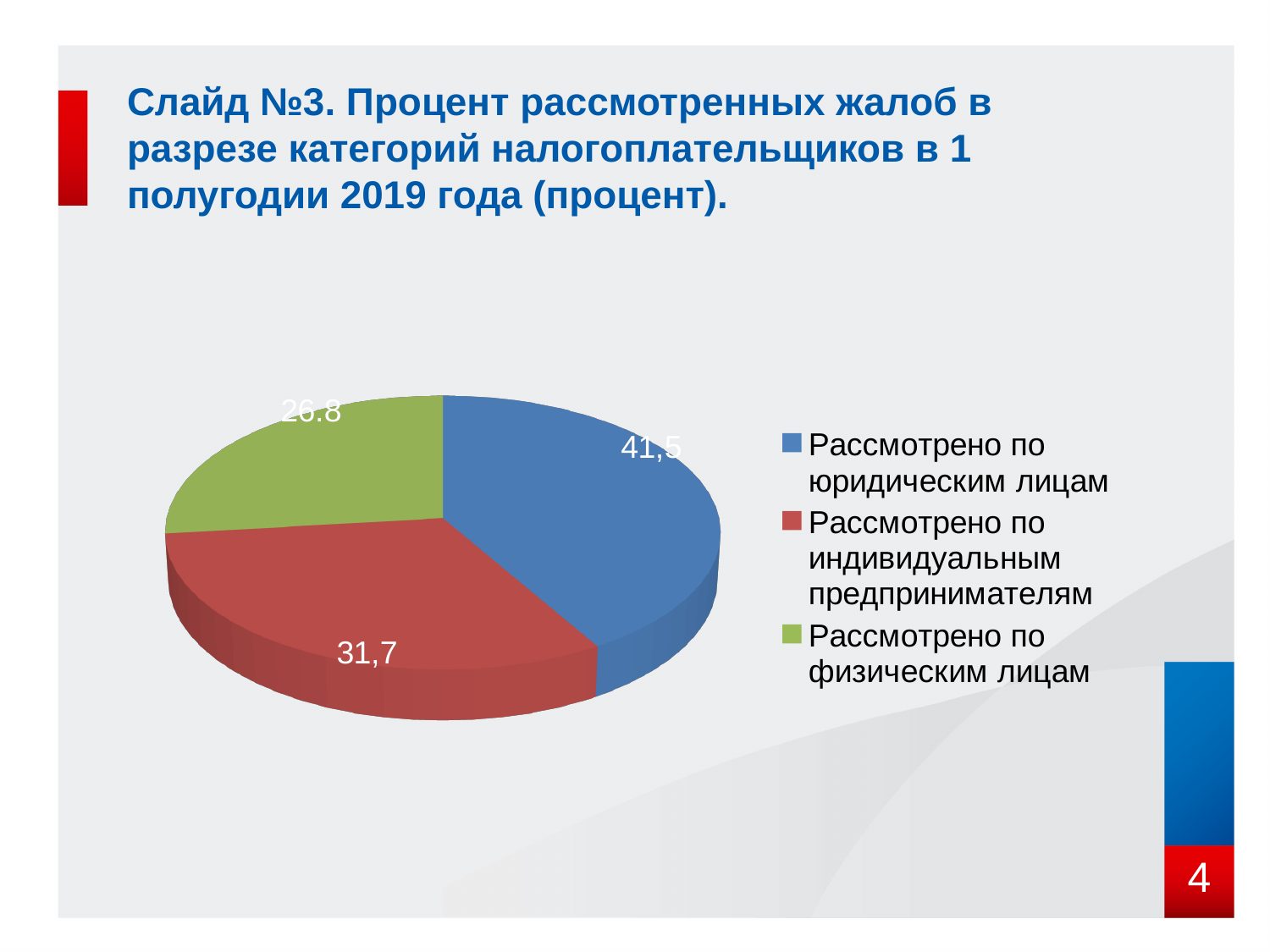
What colour is the slice for "Рассмотрено по физическим лицам"? Green What is the difference between the values for "Рассмотрено по индивидуальным предпринимателям" and "Рассмотрено по физическим лицам"? 4,9 How many slices does the pie chart have? 3 What value is shown for the slice "Рассмотрено по индивидуальным предпринимателям"? 31,7 Which category has the largest slice of the pie? Рассмотрено по юридическим лицам How many entries does the legend list? 3 What value is shown for the slice "Рассмотрено по физическим лицам"? 26.8 Which category has the smallest slice of the pie? Рассмотрено по физическим лицам What value is shown for the slice "Рассмотрено по юридическим лицам"? 41,5 What is the difference between the values for "Рассмотрено по юридическим лицам" and "Рассмотрено по индивидуальным предпринимателям"? 9,8 Which is larger: the value for "Рассмотрено по индивидуальным предпринимателям" or for "Рассмотрено по физическим лицам"? Рассмотрено по индивидуальным предпринимателям What kind of chart is shown on the slide? Pie chart